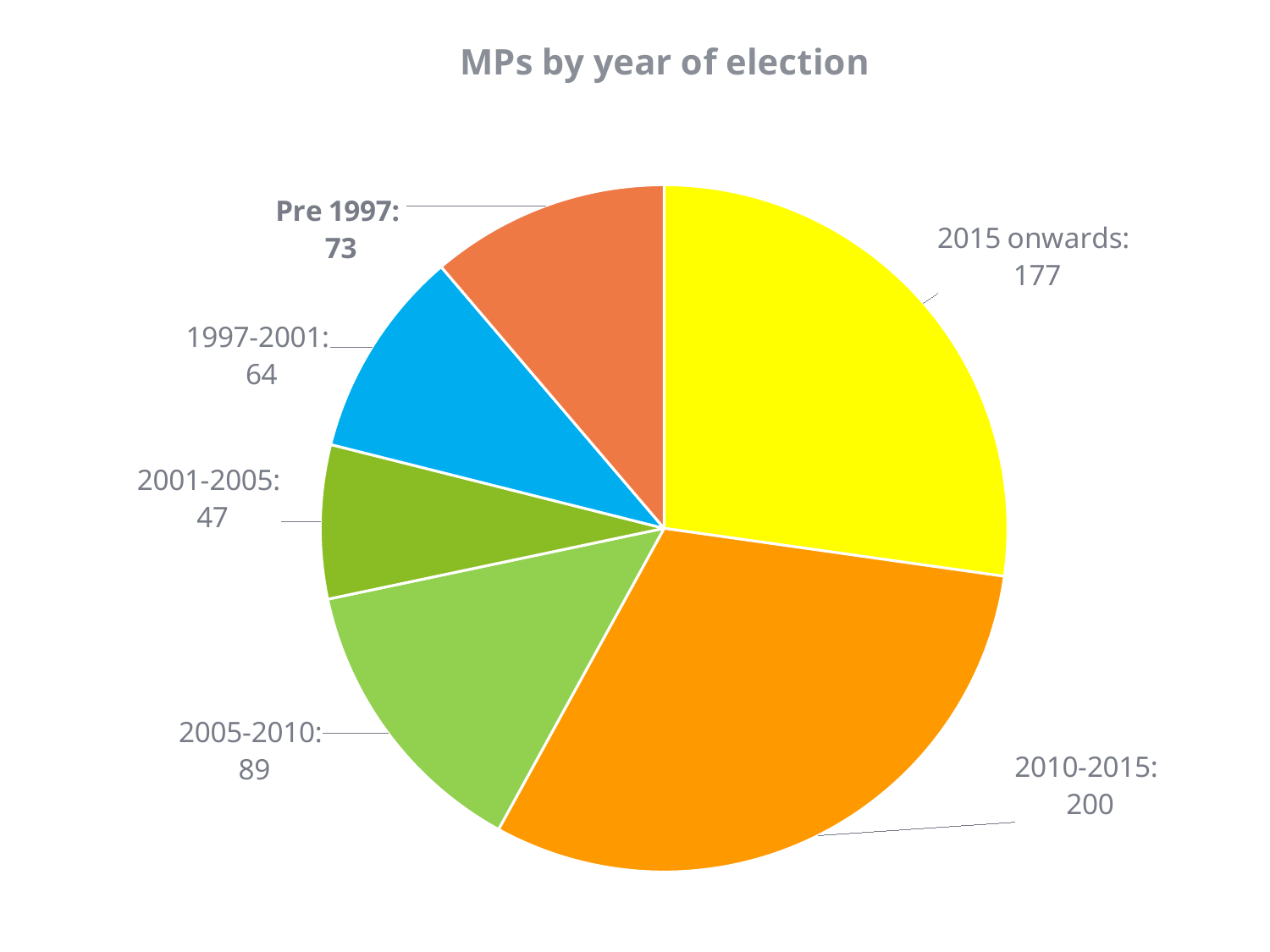
What type of chart is shown on the slide? Pie chart What is the difference between the number of MPs elected in 2010-2015 and 2015 onwards? 23 Which period has the largest number of MPs? 2010-2015 How many MPs were elected in 2010-2015? 200 What colour is the slice for 2015 onwards? Yellow How many MPs were elected in 2001-2005? 47 What is the total number of MPs across all slices of the pie? 650 What is the title of the chart? MPs by year of election Which has more MPs: 1997-2001 or 2005-2010? 2005-2010 How many MPs were elected pre 1997? 73 How many slices does the pie chart have? 6 Which period has the smallest number of MPs? 2001-2005